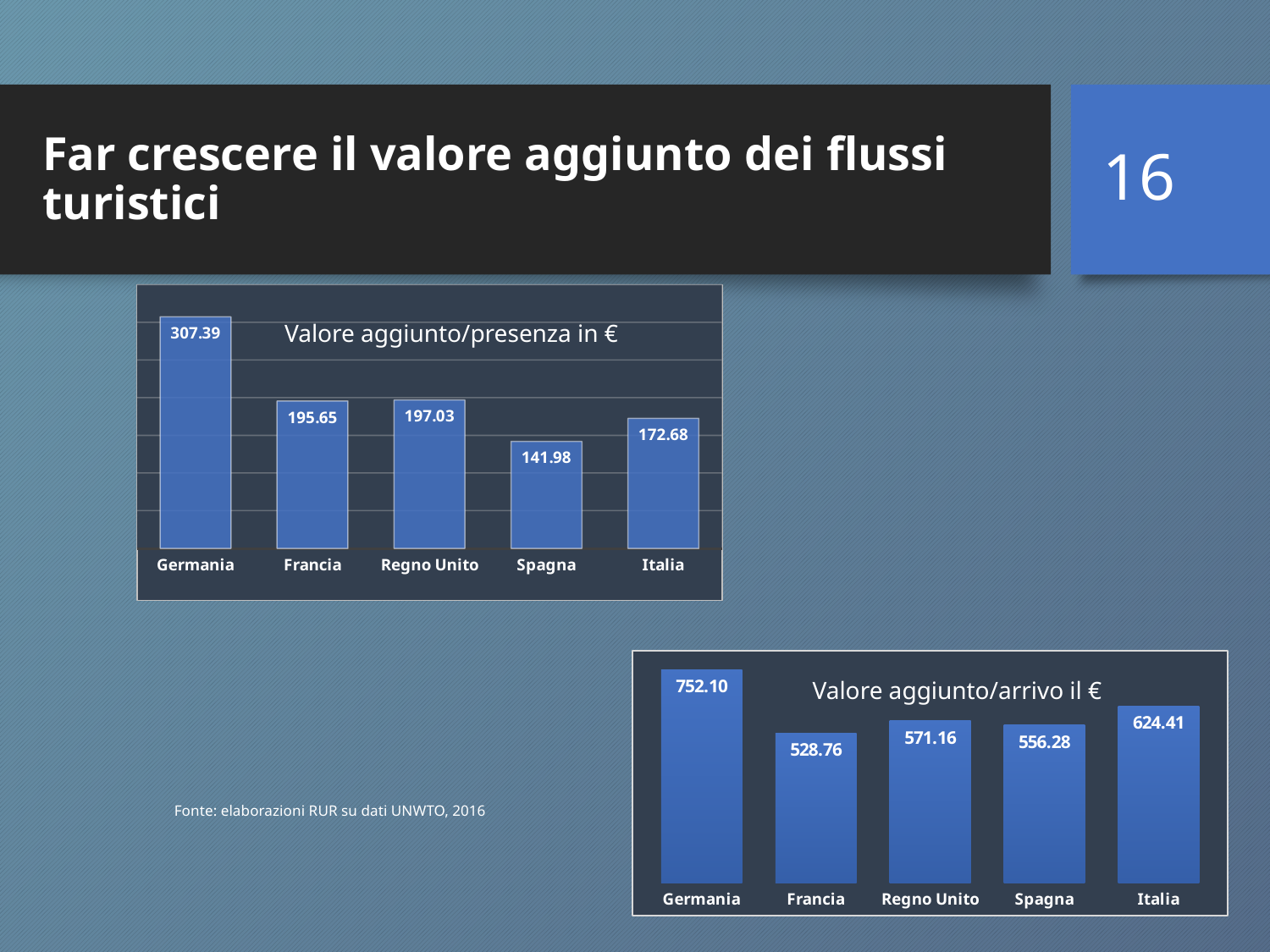
In the chart titled "Valore aggiunto/arrivo il €", which country has the lowest value? Francia In the chart titled "Valore aggiunto/arrivo il €", which country has the highest value? Germania In the chart titled "Valore aggiunto/presenza in €", what is the difference between the values for Germania and Spagna? 165.41 What kind of chart is the one titled "Valore aggiunto/arrivo il €"? Bar chart In the chart titled "Valore aggiunto/presenza in €", how many countries are shown? 5 In the chart titled "Valore aggiunto/arrivo il €", what is the difference between the values for Germania and Francia? 223.34 In the chart titled "Valore aggiunto/arrivo il €", which is larger, the value for Italia or the value for Spagna? Italia In the chart titled "Valore aggiunto/presenza in €", which country has the lowest value? Spagna In the chart titled "Valore aggiunto/arrivo il €", what is the value for Regno Unito? 571.16 In the chart titled "Valore aggiunto/presenza in €", what is the value for Germania? 307.39 In the chart titled "Valore aggiunto/arrivo il €", what is the value for Italia? 624.41 In the chart titled "Valore aggiunto/presenza in €", what is the value for Spagna? 141.98